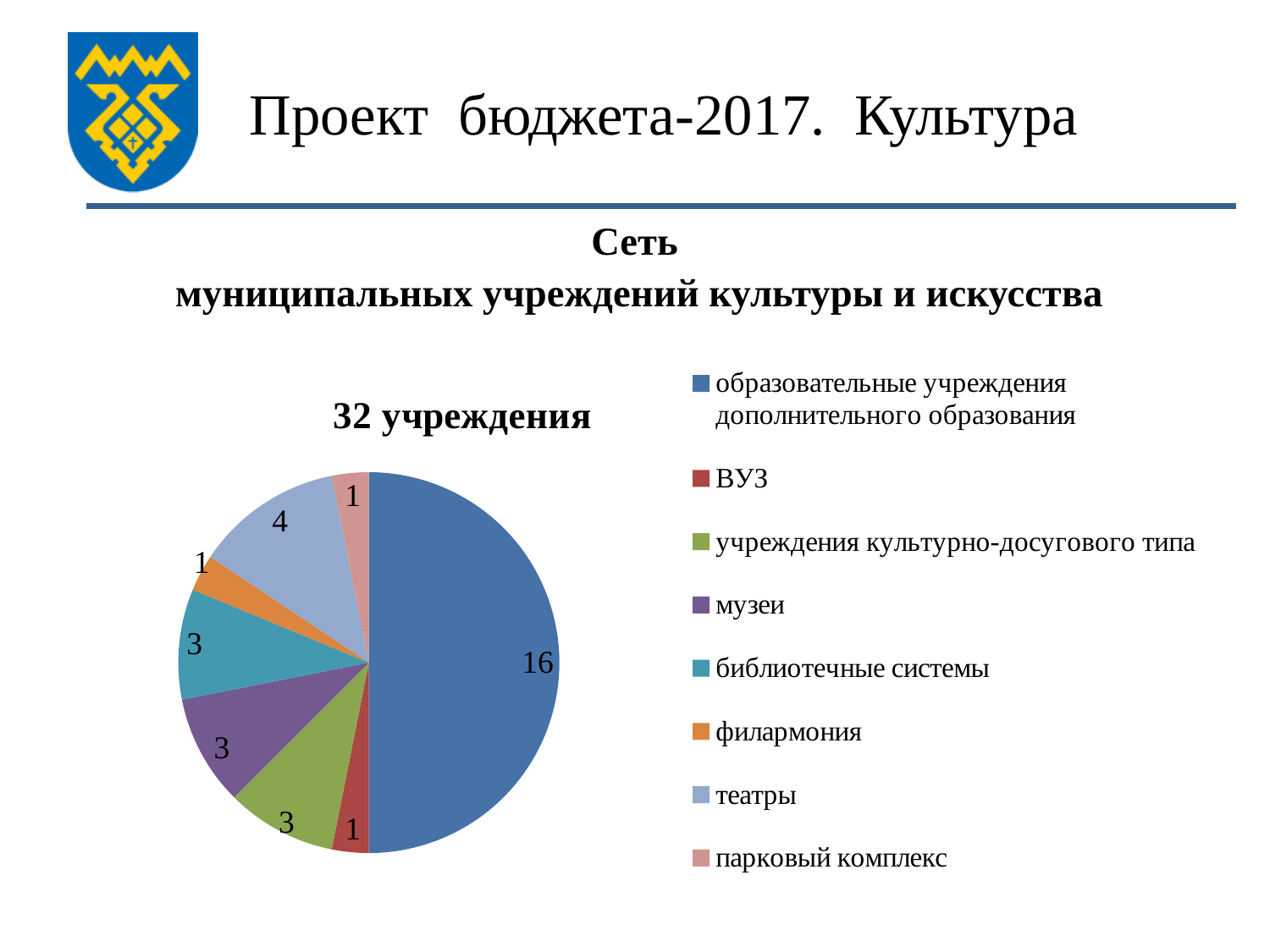
What is the difference between the values for образовательные учреждения дополнительного образования and театры? 12 Which is larger, the value for театры or the value for музеи? театры What is the value for библиотечные системы? 3 What is the title of the pie chart? 32 учреждения Which category has the largest slice of the pie? образовательные учреждения дополнительного образования What is the value for образовательные учреждения дополнительного образования? 16 How many slices does the pie chart have? 8 How many entries does the legend list? 8 What is the value for театры? 4 What is the value for филармония? 1 What share of the pie does образовательные учреждения дополнительного образования represent? 50% What kind of chart is shown on the slide? pie chart